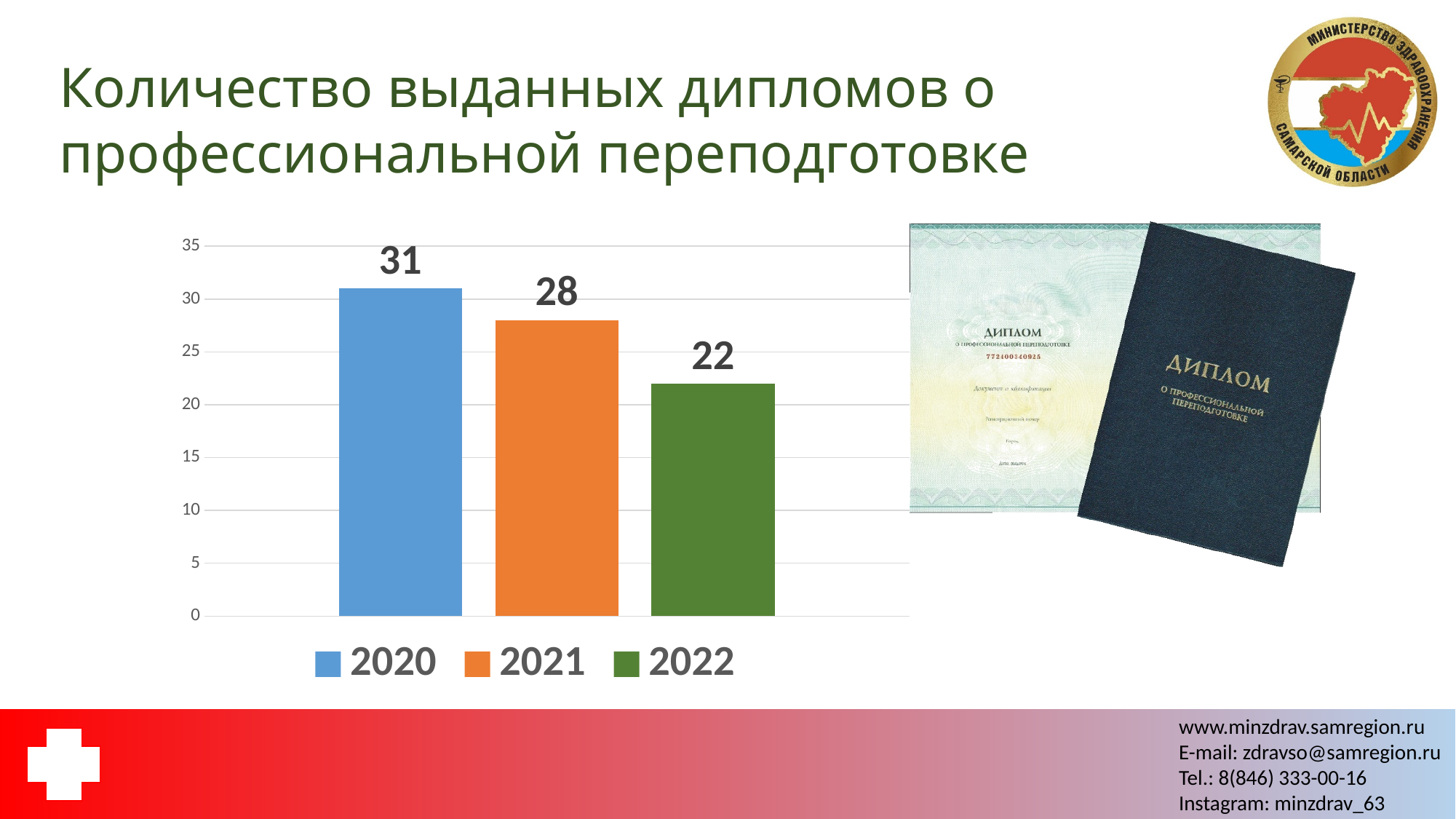
Which is larger, the value for 2020 or the value for 2021? 2020 Which year has the highest value in the chart? 2020 Which year has the lowest value in the chart? 2022 Is the value for 2022 greater or less than 25? less What kind of chart is shown on the slide? bar chart What is the difference between the values for 2020 and 2022? 9 Do the values rise or fall from 2020 to 2022? fall What is the value shown for 2021? 28 How many bars are shown in the chart? 3 What is the value shown for 2022? 22 What is the difference between the values for 2021 and 2022? 6 How many diplomas were issued in 2020 according to the chart? 31